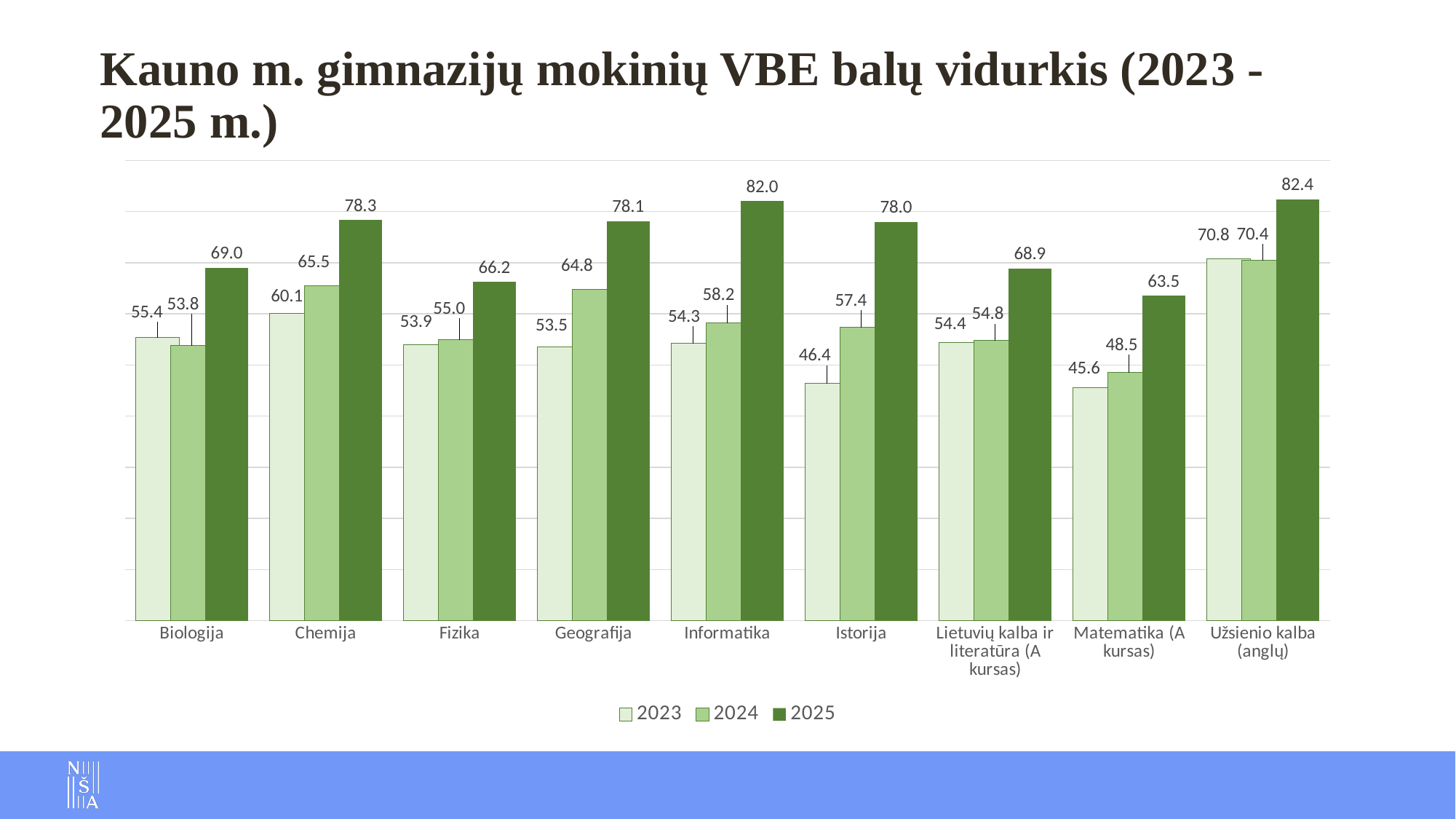
What is the 2025 value for Informatika? 82.0 Which subject has the lowest 2023 value? Matematika (A kursas) What is the 2024 value for Lietuvių kalba ir literatūra (A kursas)? 54.8 What is the 2023 value for Matematika (A kursas)? 45.6 What is the title of the chart? Kauno m. gimnazijų mokinių VBE balų vidurkis (2023 - 2025 m.) What is the difference between the 2025 and 2023 values for Istorija? 31.6 How many subjects are shown on the x axis? 9 What kind of chart is shown on the slide? Bar chart How many series does the legend list? 3 Do the values for Istorija rise or fall from 2023 to 2025? Rise Which subject has the highest 2025 value? Užsienio kalba (anglų) Which is larger: the 2024 value for Chemija or the 2024 value for Geografija? Chemija